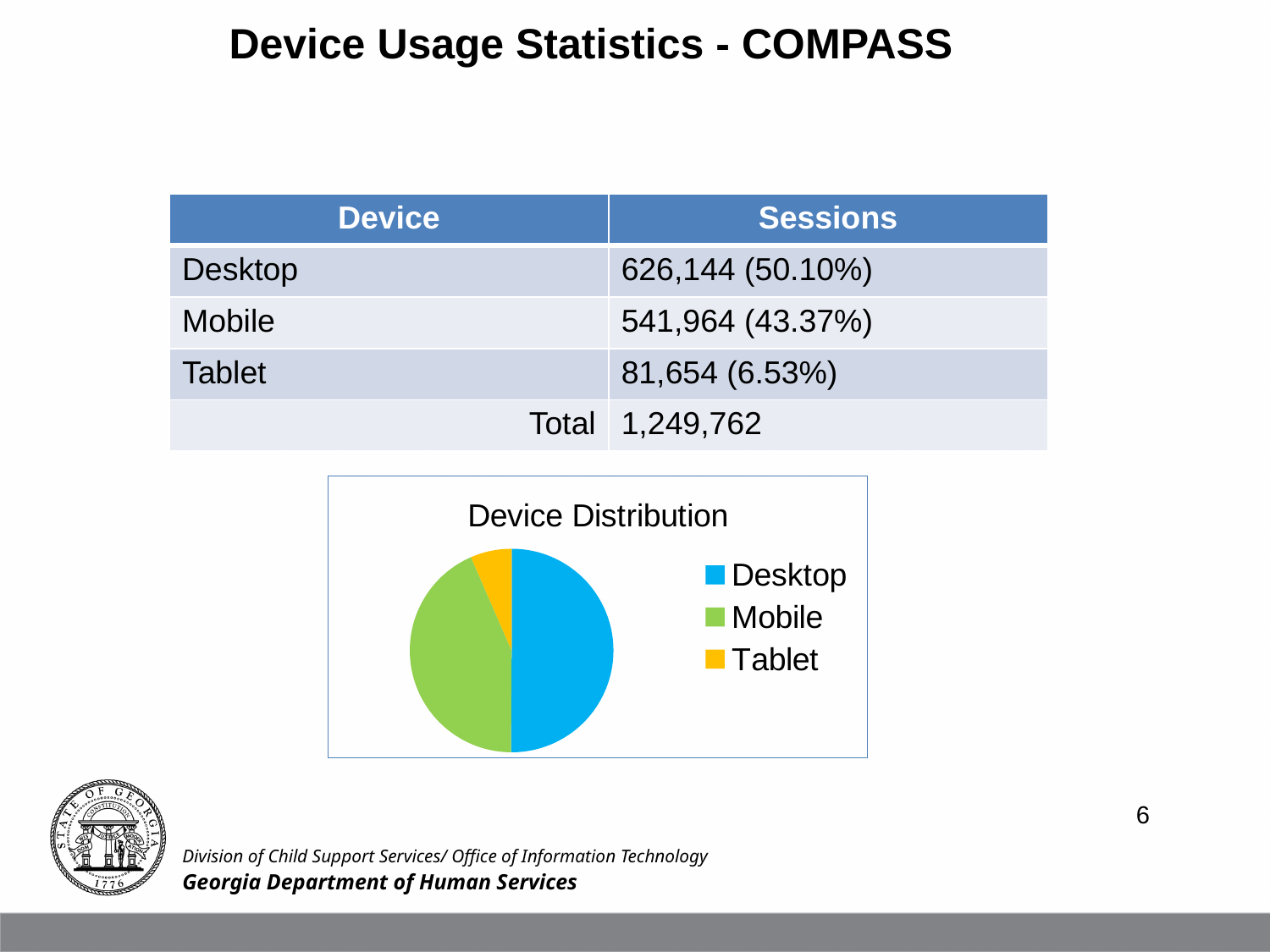
What is the total number of sessions across all three device slices? 1,249,762 What kind of chart is shown on the slide? pie chart What share of sessions does the Tablet slice represent, according to the slide? 6.53% What is the title of the chart? Device Distribution How many entries does the legend of the Device Distribution chart list? 3 Which device has the largest slice in the Device Distribution pie chart? Desktop What colour is the Mobile slice in the Device Distribution pie chart? green What share of sessions does the Desktop slice represent, according to the slide? 50.10% How many sessions does the Mobile slice represent, according to the table on the slide? 541,964 Which device has the smallest slice in the Device Distribution pie chart? Tablet Which slice is larger in the Device Distribution pie chart, Mobile or Tablet? Mobile How many slices does the Device Distribution pie chart have? 3